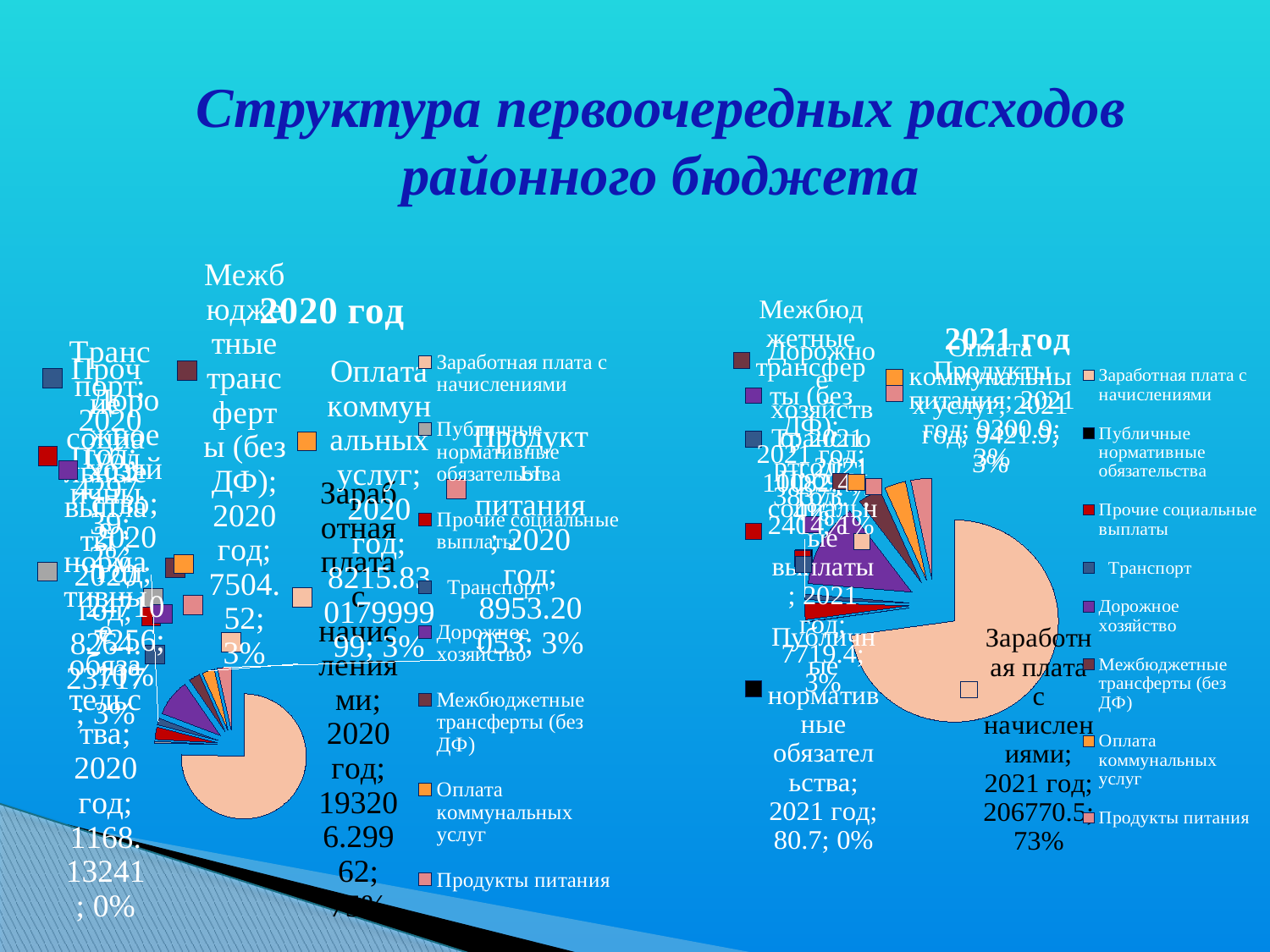
In the "2021 год" chart, what share of the pie is Заработная плата с начислениями? 73% In the "2020 год" chart, what share of the pie is Заработная плата с начислениями? 75% What kind of chart is the "2020 год" chart? pie chart In the "2021 год" chart, what is the value for Оплата коммунальных услуг? 9421.9 In the "2021 год" chart, what is the value for Публичные нормативные обязательства? 80.7 How many entries does the legend of the "2021 год" chart list? 8 In the "2021 год" chart, which is larger: Продукты питания or Оплата коммунальных услуг? Оплата коммунальных услуг In the "2020 год" chart, which category has the largest slice? Заработная плата с начислениями In the "2021 год" chart, what is the value for Продукты питания? 9300.9 What is the title of the slide containing the two pie charts? Структура первоочередных расходов районного бюджета In the "2020 год" chart, what is the value for Транспорт? 4297.39 In the "2020 год" chart, what is the value for Межбюджетные трансферты (без ДФ)? 7504.52